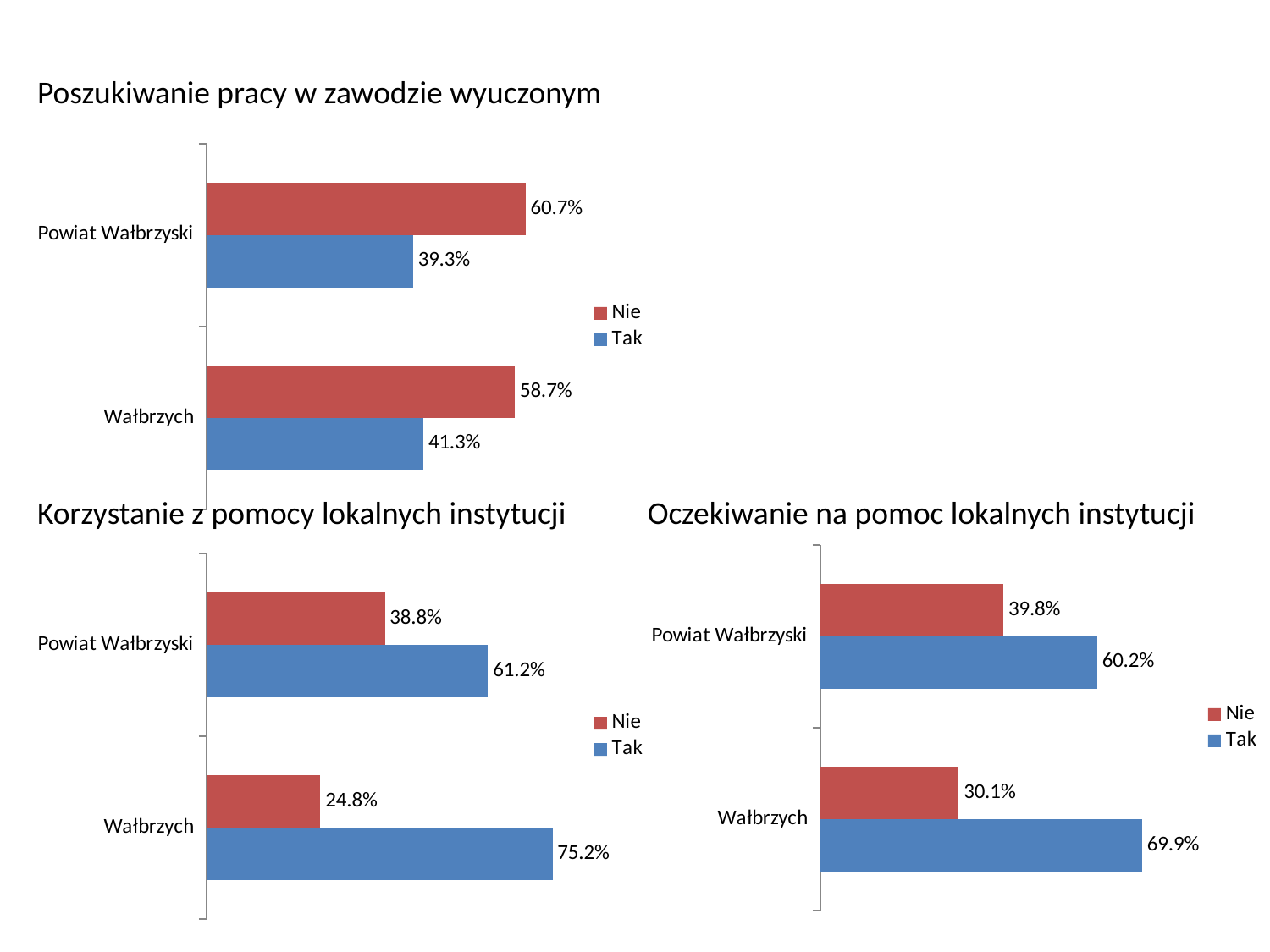
What kind of chart is 'Poszukiwanie pracy w zawodzie wyuczonym'? Bar chart In the chart 'Korzystanie z pomocy lokalnych instytucji', what is the value for 'Nie' for Powiat Wałbrzyski? 38.8% In the chart 'Oczekiwanie na pomoc lokalnych instytucji', what is the difference between 'Tak' and 'Nie' for Powiat Wałbrzyski? 20.4% In the chart 'Oczekiwanie na pomoc lokalnych instytucji', what is the value for 'Nie' for Wałbrzych? 30.1% In the chart 'Oczekiwanie na pomoc lokalnych instytucji', which is larger for Wałbrzych, 'Tak' or 'Nie'? Tak In the chart 'Poszukiwanie pracy w zawodzie wyuczonym', what is the difference between 'Nie' and 'Tak' for Wałbrzych? 17.4% In the chart 'Oczekiwanie na pomoc lokalnych instytucji', what is the value for 'Tak' for Powiat Wałbrzyski? 60.2% How many series does the legend of the chart 'Korzystanie z pomocy lokalnych instytucji' list? 2 In the chart 'Korzystanie z pomocy lokalnych instytucji', which category has the lowest 'Nie' value? Wałbrzych In the chart 'Korzystanie z pomocy lokalnych instytucji', what is the value for 'Tak' for Wałbrzych? 75.2% In the chart 'Poszukiwanie pracy w zawodzie wyuczonym', what is the value for 'Nie' for Powiat Wałbrzyski? 60.7% In the chart 'Poszukiwanie pracy w zawodzie wyuczonym', what is the value for 'Tak' for Wałbrzych? 41.3%